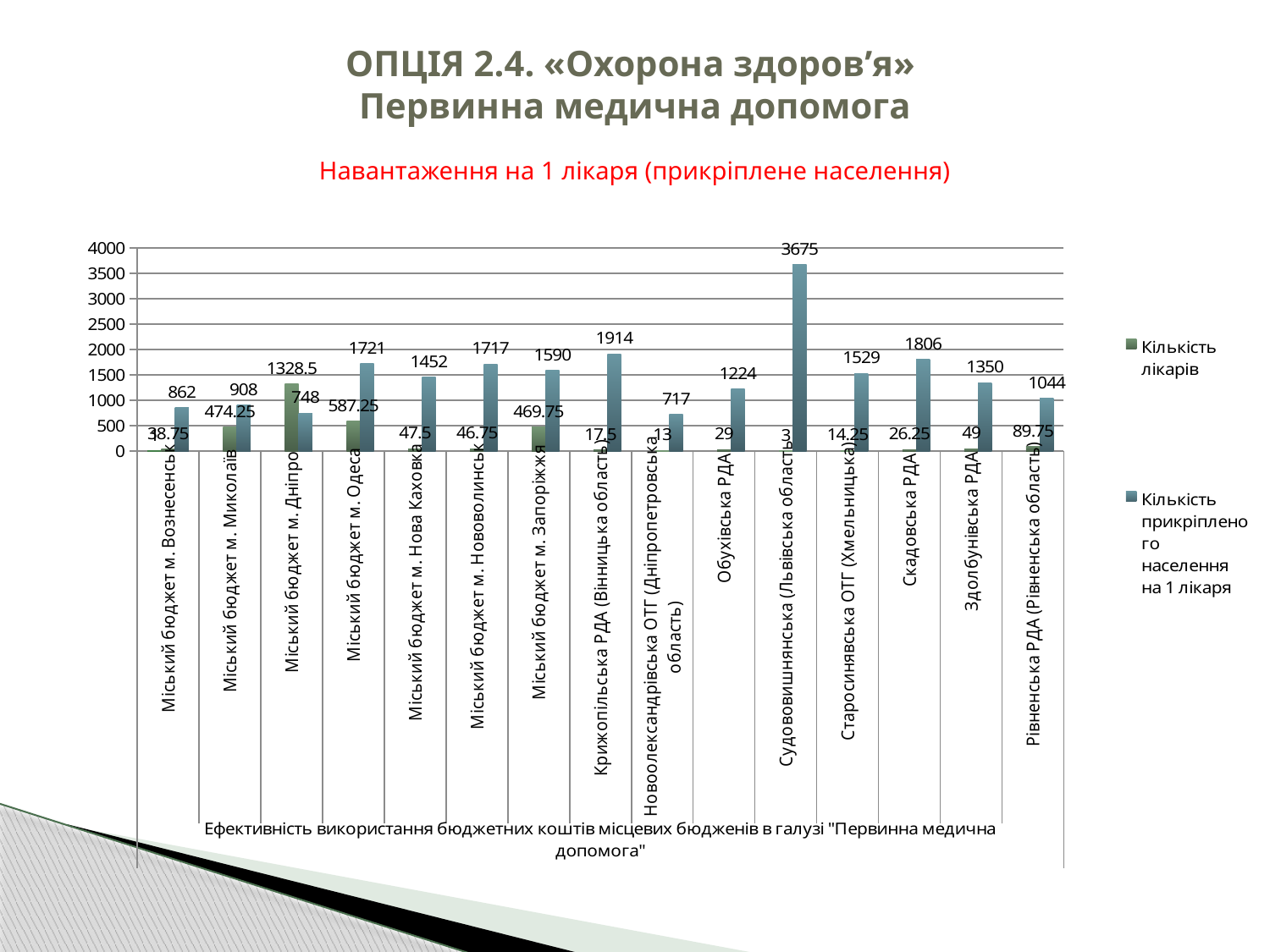
How many categories are shown on the x axis? 15 What is the title shown in red above the chart? Навантаження на 1 лікаря (прикріплене населення) What is the value of 'Кількість прикріпленого населення на 1 лікаря' for Міський бюджет м. Одеса? 1721 What is the difference in 'Кількість прикріпленого населення на 1 лікаря' between Скадовська РДА and Здолбунівська РДА? 456 What is the value of 'Кількість лікарів' for Міський бюджет м. Дніпро? 1328.5 Which category has the highest 'Кількість прикріпленого населення на 1 лікаря'? Судововишнянська (Львівська область) Which is larger: 'Кількість прикріпленого населення на 1 лікаря' for Міський бюджет м. Нововолинськ or for Міський бюджет м. Запоріжжя? Міський бюджет м. Нововолинськ Which category has the lowest 'Кількість прикріпленого населення на 1 лікаря'? Новоолександрівська ОТГ (Дніпропетровська область) What type of chart is shown on the slide? bar chart How many series does the legend list? 2 What is the value of 'Кількість прикріпленого населення на 1 лікаря' for Судововишнянська (Львівська область)? 3675 Which category has the lowest 'Кількість лікарів'? Судововишнянська (Львівська область)